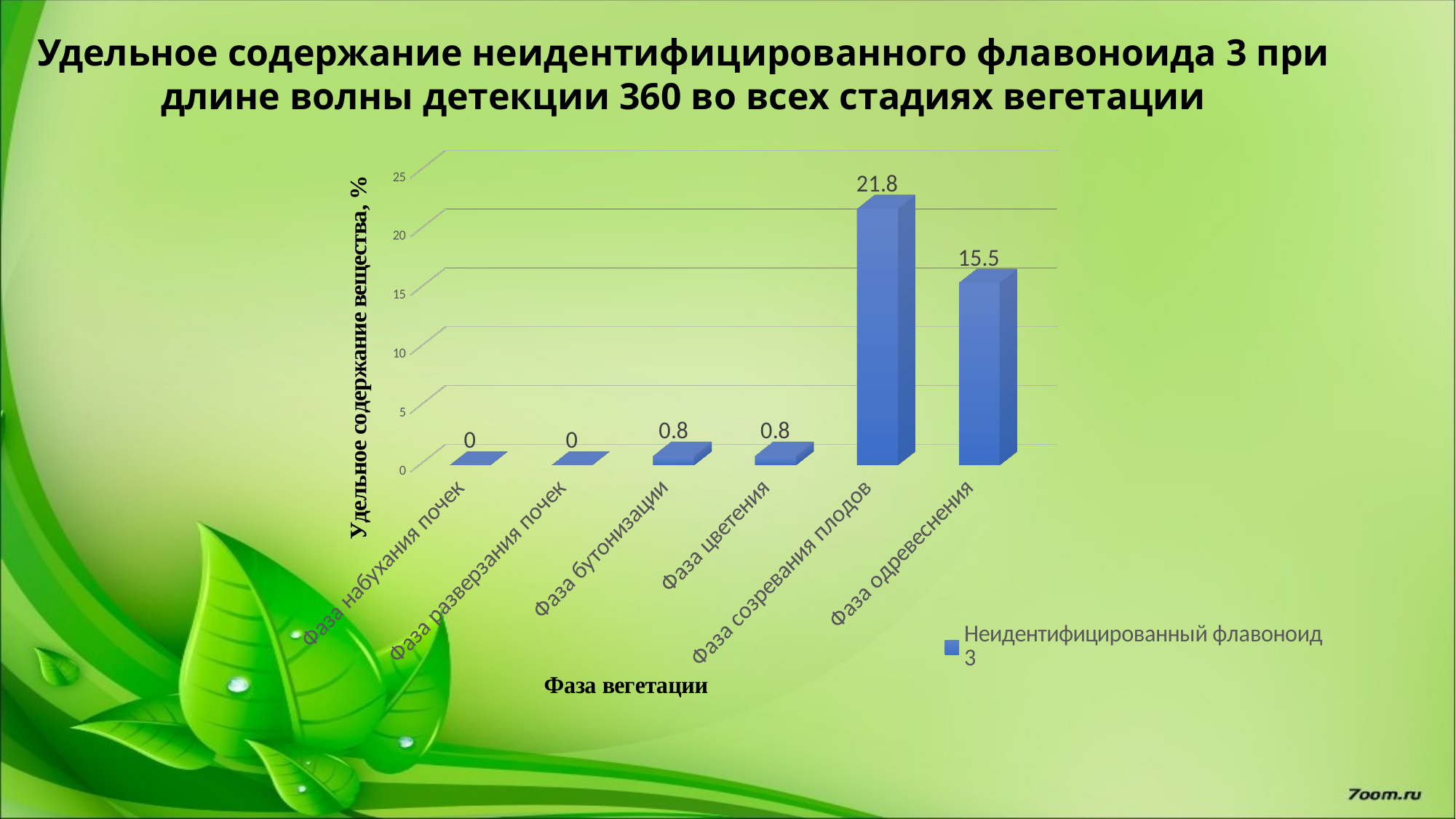
How many series does the legend list? 1 What is the value for Фаза бутонизации? 0.8 What is the label of the y axis? Удельное содержание вещества, % What is the value for Фаза созревания плодов? 21.8 What is the value for Фаза одревеснения? 15.5 Which is larger, the value for Фаза цветения or the value for Фаза одревеснения? Фаза одревеснения Which vegetation phase has the highest value? Фаза созревания плодов What kind of chart is shown on the slide? bar chart What is the value for Фаза набухания почек? 0 What is the difference between the values for Фаза созревания плодов and Фаза одревеснения? 6.3 How many vegetation phases are shown on the x axis? 6 Is the value for Фаза созревания плодов greater or less than 20? greater